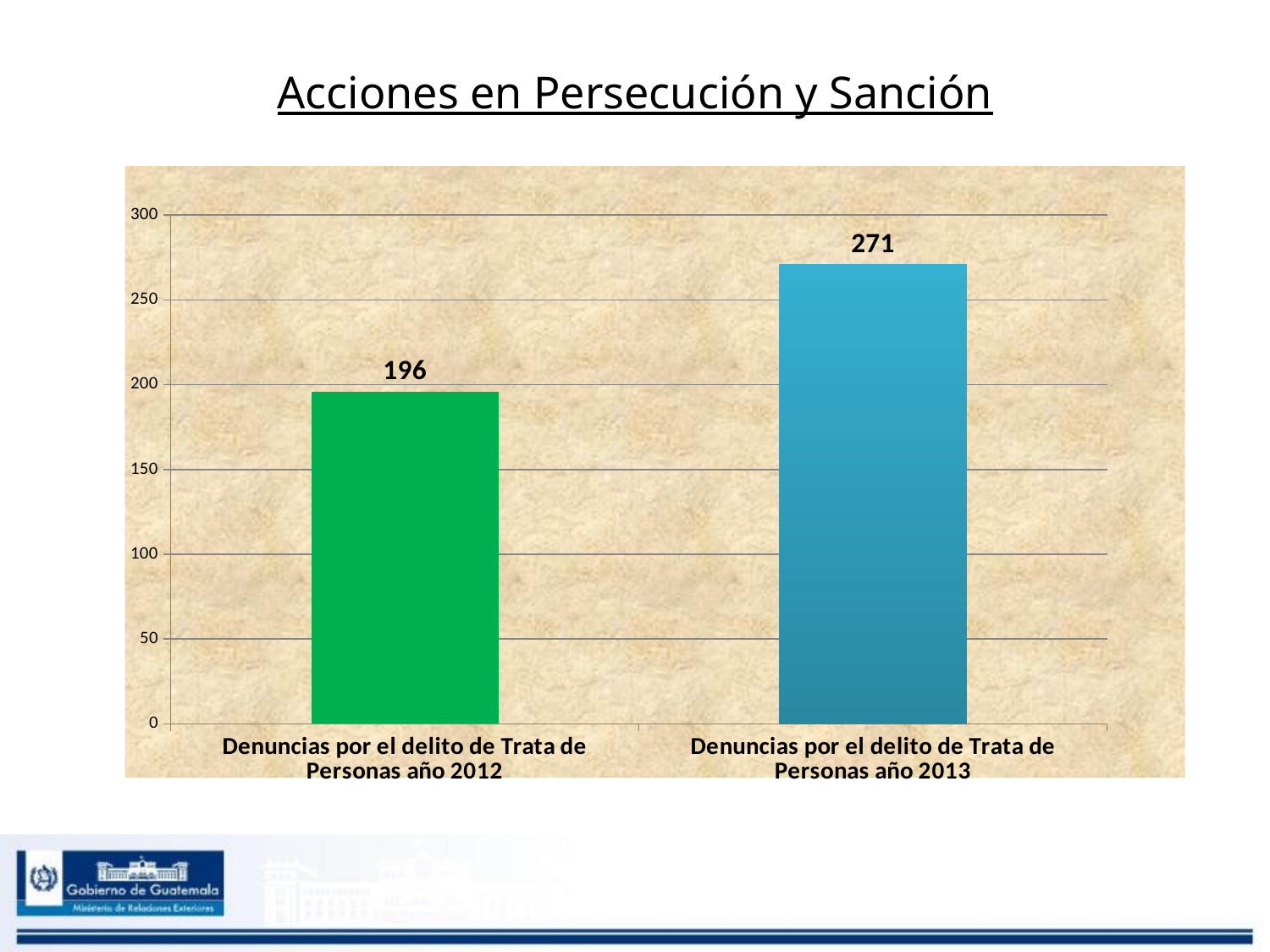
What is the title of the slide? Acciones en Persecución y Sanción Which category has the highest value? Denuncias por el delito de Trata de Personas año 2013 How many categories are shown in the chart? 2 Is the value for Denuncias por el delito de Trata de Personas año 2012 greater or less than 200? less Which category has the lowest value? Denuncias por el delito de Trata de Personas año 2012 What is the value for Denuncias por el delito de Trata de Personas año 2013? 271 What is the difference between the values for año 2013 and año 2012? 75 Do the values rise or fall from año 2012 to año 2013? rise Which is larger, the value for año 2012 or the value for año 2013? año 2013 Is the value for Denuncias por el delito de Trata de Personas año 2013 greater or less than 250? greater What is the value for Denuncias por el delito de Trata de Personas año 2012? 196 What kind of chart is shown on the slide? bar chart